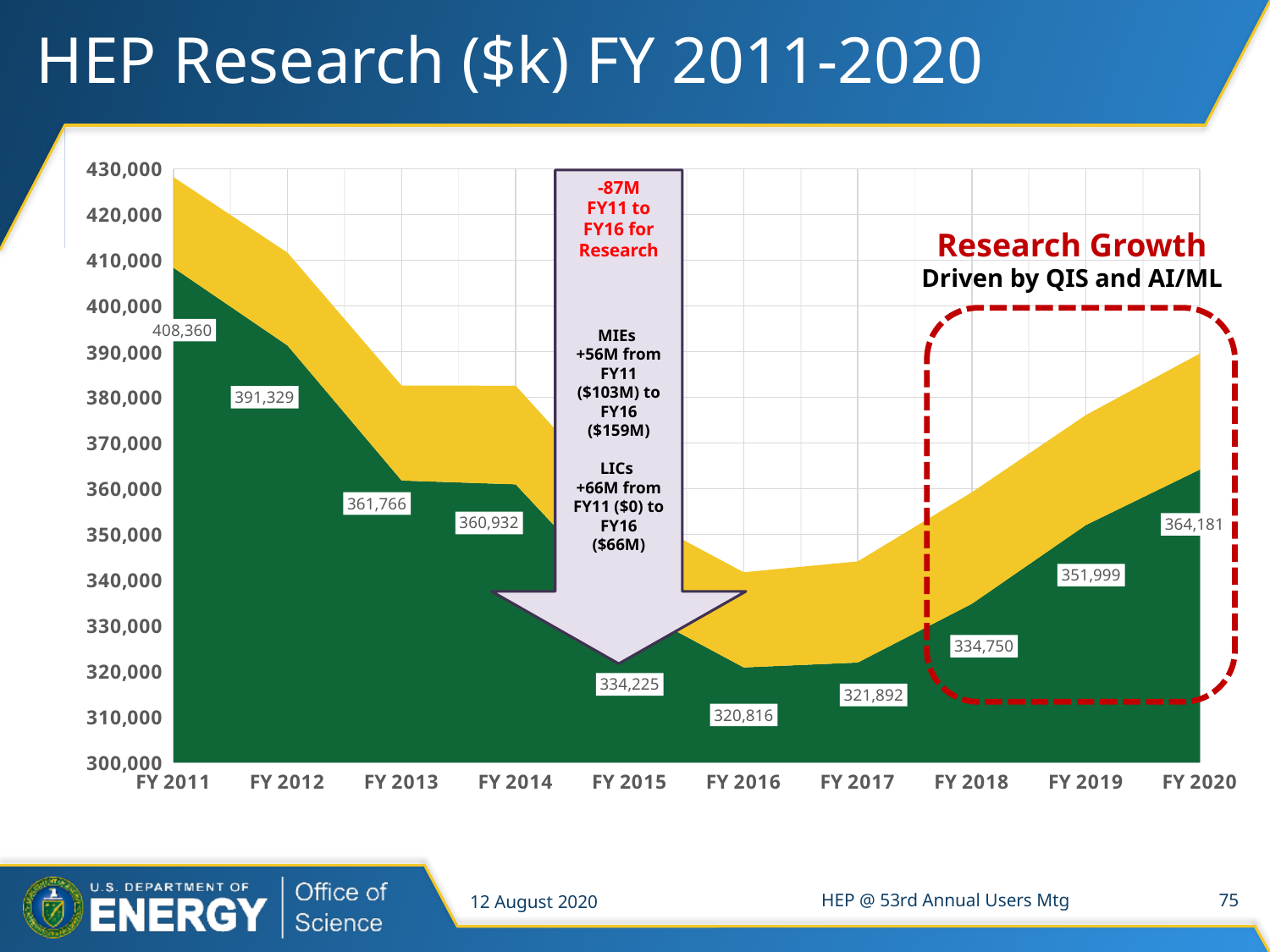
What is the labeled value for FY 2016? 320,816 Which fiscal year has the lowest labeled value? FY 2016 What kind of chart is shown on the slide? Area chart What is the labeled value for FY 2011? 408,360 How many fiscal years are shown on the x axis? 10 Do the labeled values rise or fall from FY 2016 to FY 2020? Rise What is the difference between the labeled values for FY 2011 and FY 2016? 87,544 What is the labeled value for FY 2018? 334,750 Which fiscal year has the highest labeled value? FY 2011 Is the labeled value for FY 2013 greater or less than 350,000? greater Which is larger, the labeled value for FY 2019 or for FY 2018? FY 2019 What is the labeled value for FY 2020? 364,181